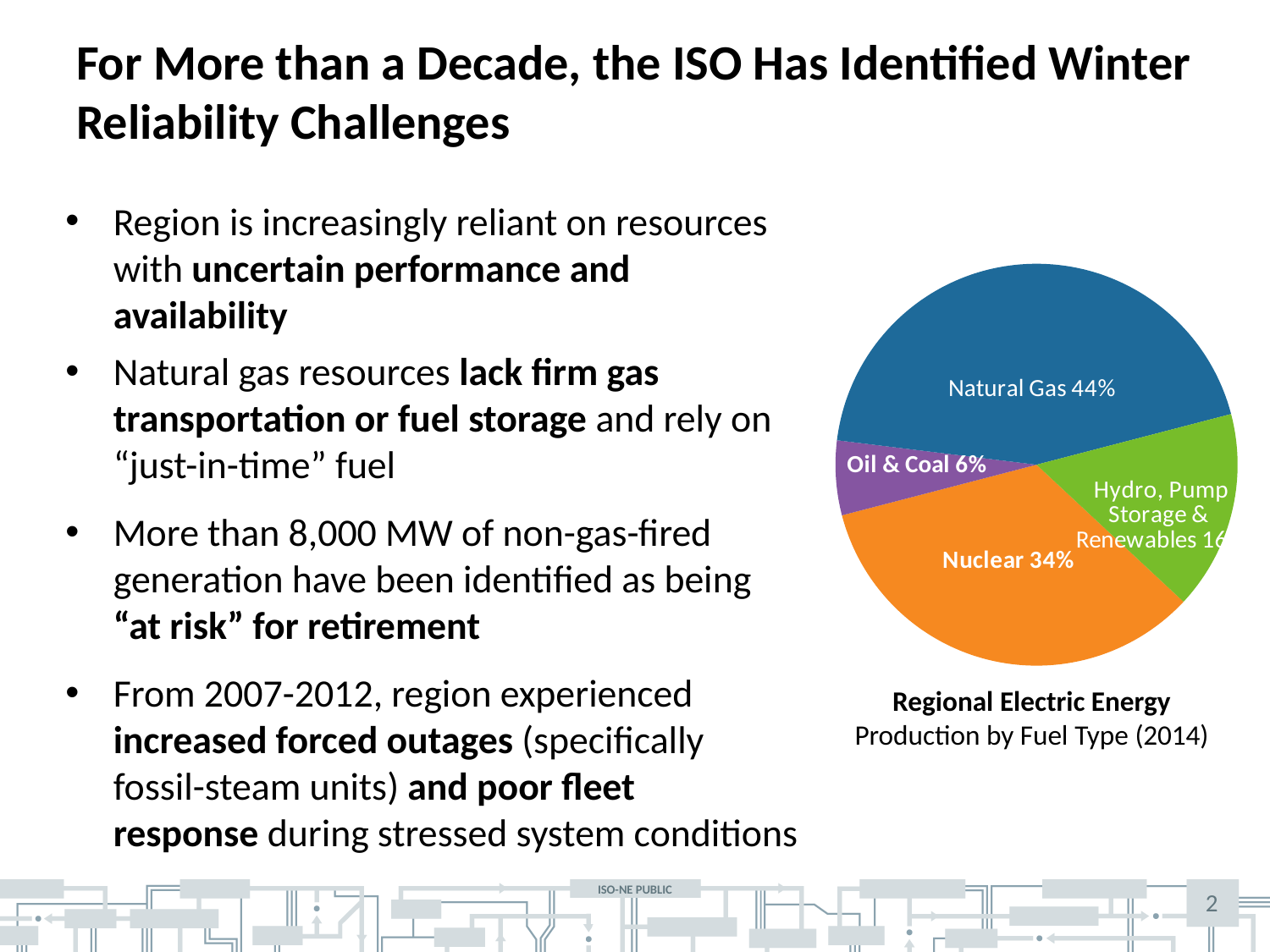
What share of regional electric energy production does Natural Gas account for in the pie chart? 44% How many fuel type categories are shown in the pie chart? 4 What kind of chart is shown on the slide? Pie chart Which slice is larger, Natural Gas or Hydro, Pump Storage & Renewables? Natural Gas What percentage is shown for Oil & Coal in the pie chart? 6% Which fuel type has the largest slice of the pie chart? Natural Gas What percentage is shown for Nuclear in the pie chart? 34% Which is larger in the pie chart, Nuclear or Oil & Coal? Nuclear What is the combined share of Natural Gas and Nuclear in the pie chart? 78% Which fuel type has the smallest slice of the pie chart? Oil & Coal How many percentage points larger is the Natural Gas share than the Nuclear share? 10 percentage points What is the title of the pie chart? Regional Electric Energy Production by Fuel Type (2014)